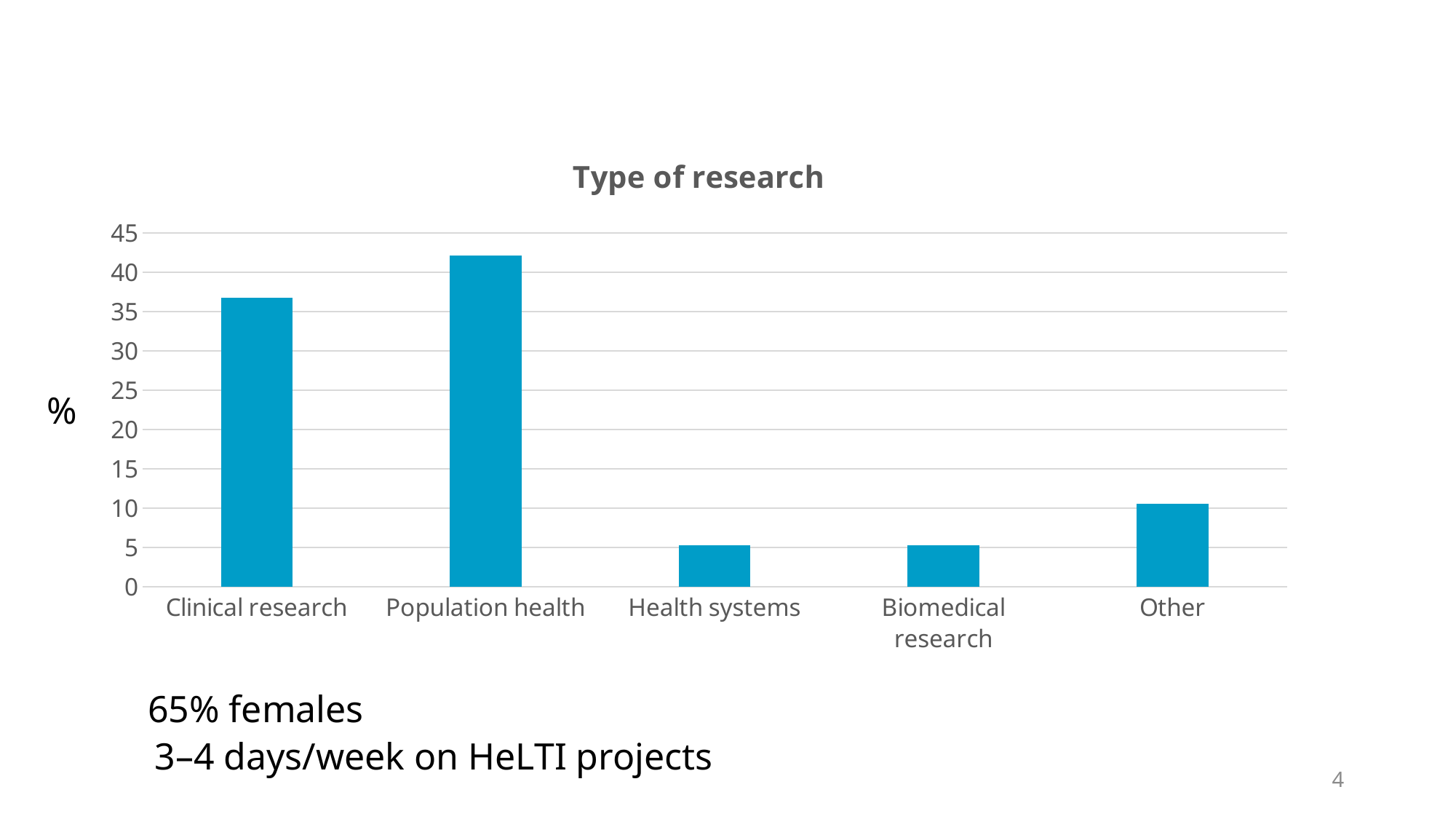
Which is larger, the value for Other or the value for Biomedical research? Other Is the value for Clinical research greater or less than 40? less Which is larger, the value for Clinical research or the value for Population health? Population health Is the value for Health systems greater or less than 10? less Is the value for Population health greater or less than 40? greater How many categories are shown on the x axis of the chart? 5 What is the title of the chart? Type of research What label is shown on the vertical axis of the chart? % What type of chart is shown on the slide? bar chart Which type of research has the highest value? Population health